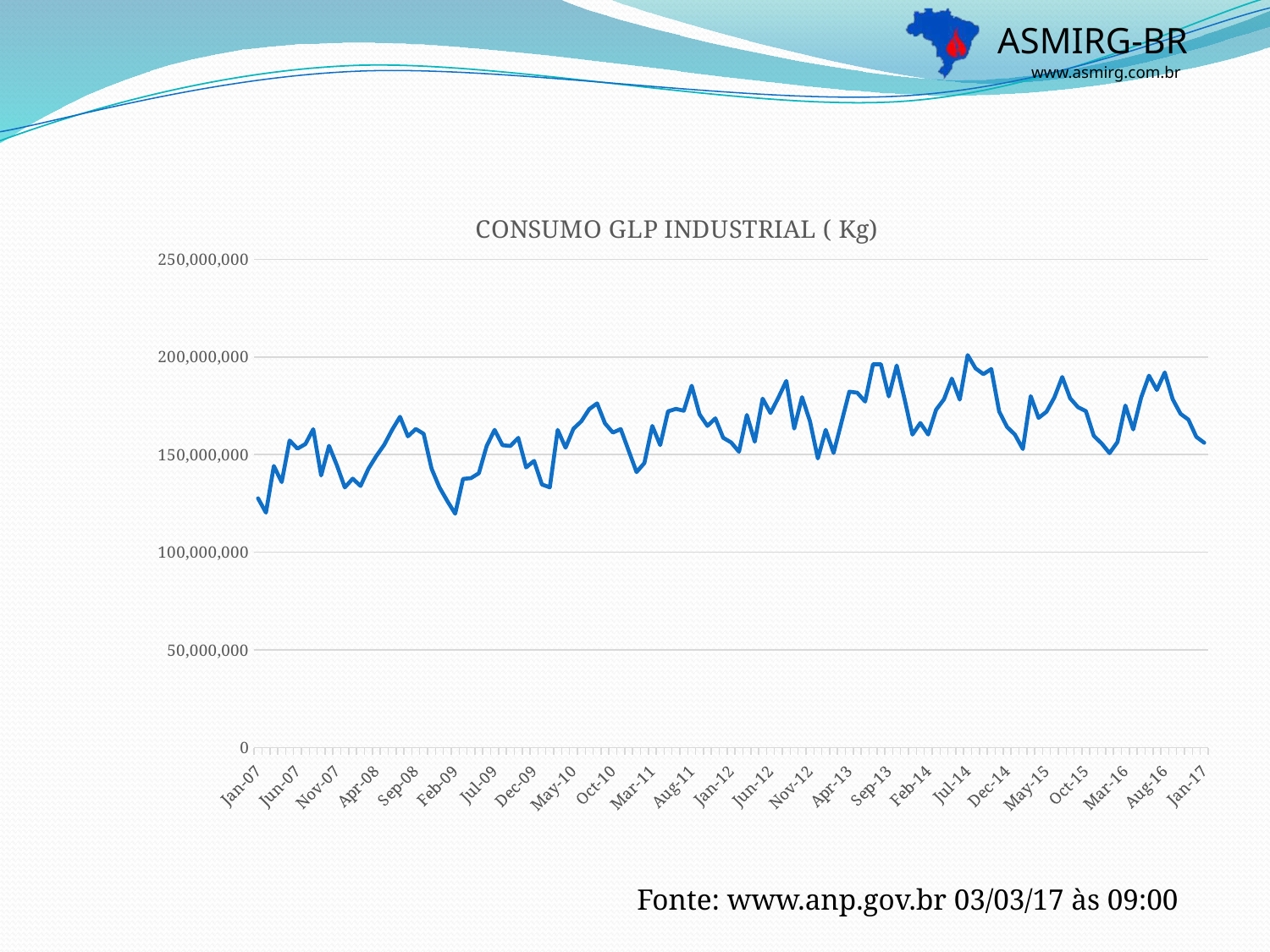
Does the line rise or fall between Jul-14 and Dec-14? fall Are all the plotted values greater or less than 100,000,000? greater Is the value for Sep-08 greater or less than 150,000,000? greater What kind of chart is shown on the slide? line chart Is the value for Jan-17 greater or less than 150,000,000? greater What is the title of the chart? CONSUMO GLP INDUSTRIAL ( Kg) Which is larger, the value for Sep-08 or the value for Feb-09? Sep-08 What is the highest value shown on the vertical axis of the chart? 250,000,000 Does the line rise or fall between Jan-07 and Jun-07? rise Which is larger, the value for Jan-07 or the value for Jan-17? Jan-17